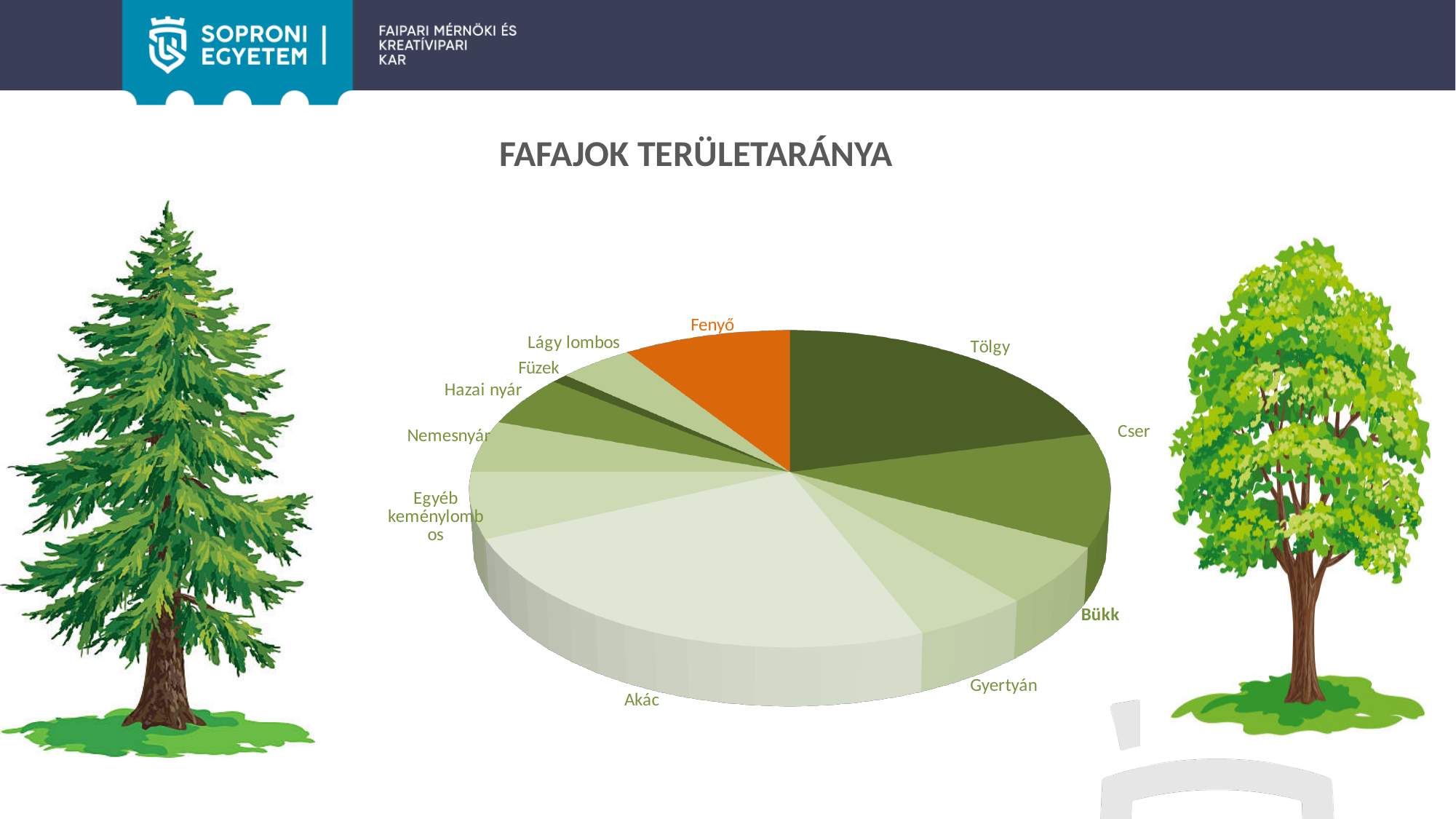
Which slice is larger, Akác or Gyertyán? Akác What is the title of the chart? FAFAJOK TERÜLETARÁNYA Which slice is larger, Hazai nyár or Füzek? Hazai nyár Which category has the smallest slice of the pie? Füzek How many slices (tree species categories) does the pie chart have? 11 Which slice is larger, Tölgy or Cser? Tölgy Which category's slice is coloured orange, unlike the green slices? Fenyő Which category has the largest slice of the pie? Akác What kind of chart is shown on the slide? Pie chart